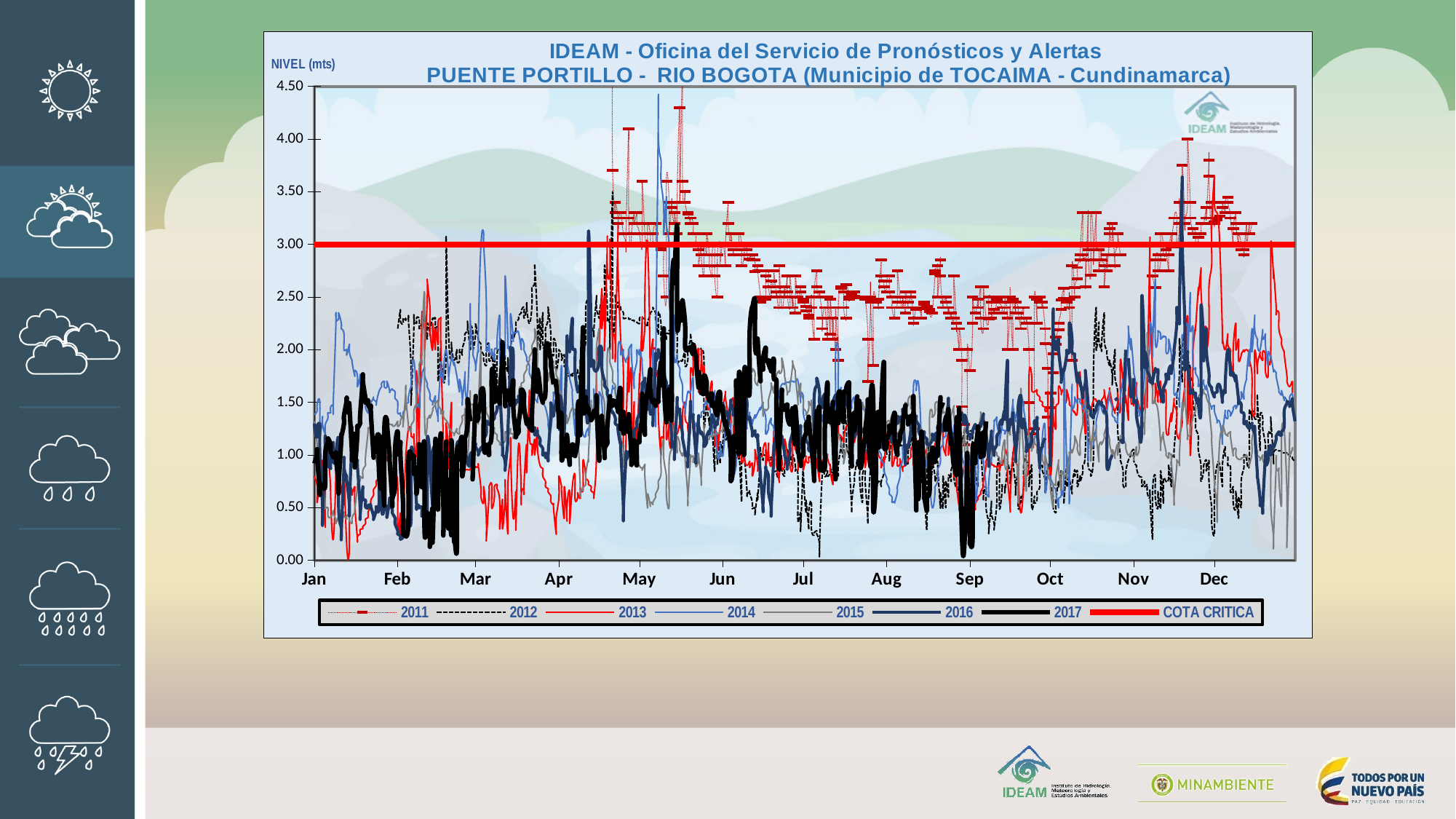
Is the 2011 series in late November greater or less than 3.00? greater How many series does the legend list? 8 At what level is the COTA CRITICA line drawn? 3.00 How many months are labelled along the x axis? 12 Is the 2011 series in August greater or less than 3.00? less What is the first month labelled on the x axis? Jan What is the highest value shown on the y axis? 4.50 What kind of chart is shown on the slide? line chart Which legend entry is drawn as a thick solid red horizontal line? COTA CRITICA Is the 2011 series in early May greater or less than 3.00? greater What is the label of the y axis? NIVEL (mts)